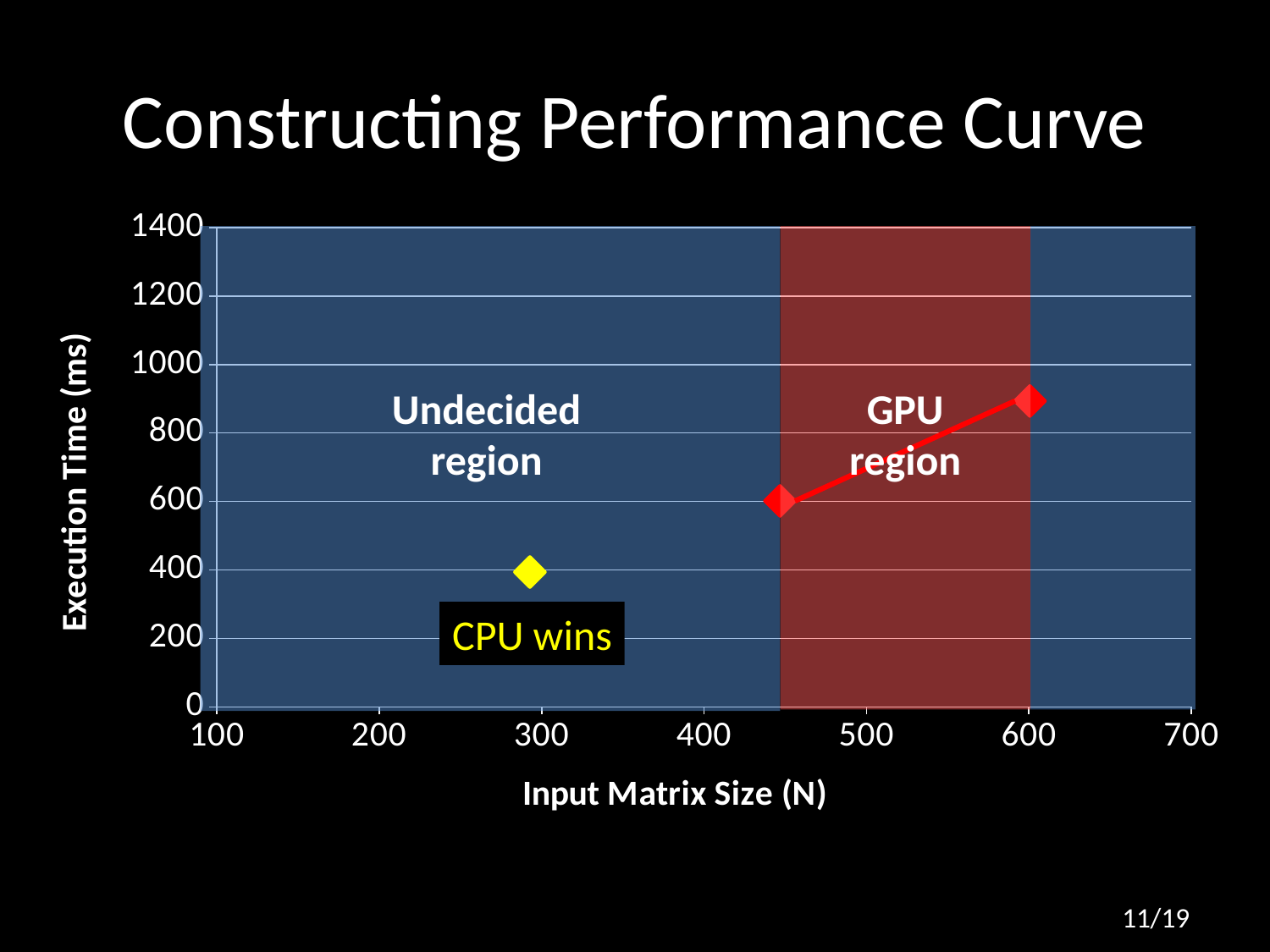
Which point has the highest execution time: the yellow 'CPU wins' point or the red point at the right edge of the GPU region? the red point at the right edge of the GPU region Which plotted point has the lowest execution time? the yellow 'CPU wins' point Is the execution time of the yellow 'CPU wins' point greater or less than 600? less Does the red line in the GPU region rise or fall as the input matrix size increases? rise What is the title of the x axis? Input Matrix Size (N) Is the execution time of the red point at the right edge of the GPU region greater or less than 1000? less How many data points are plotted on the chart? 3 What kind of chart is shown on the slide? line chart Is the execution time of the red point at the right edge of the GPU region greater or less than 800? greater What is the title of the y axis? Execution Time (ms)